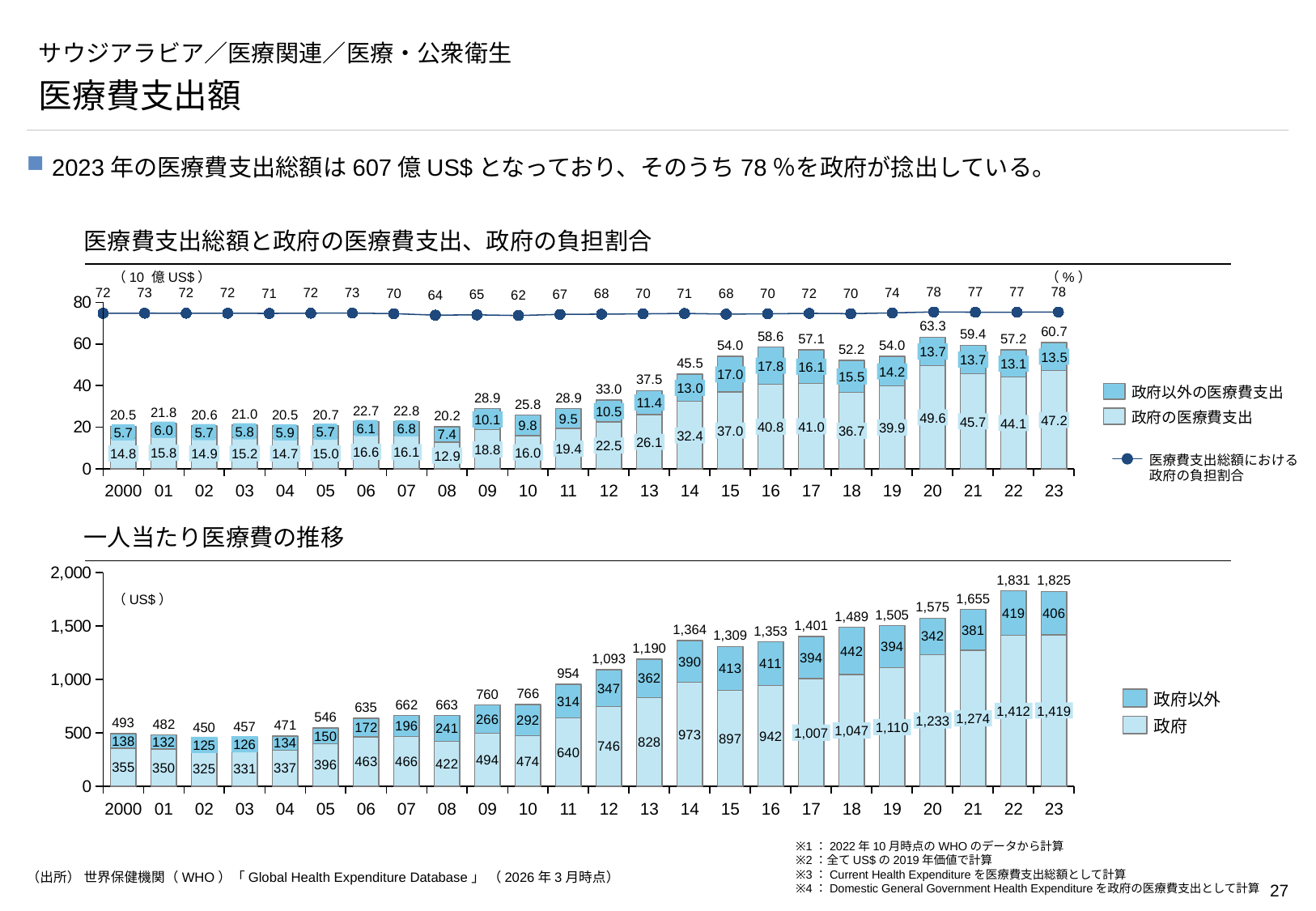
How many series does the legend of the top chart list? 3 In the top chart (医療費支出総額と政府の医療費支出、政府の負担割合), what is the value of 政府の医療費支出 for 2023? 47.2 In the top chart, what is the difference between the total health expenditure in 2023 and in 2022? 3.5 In the bottom chart, what is the 政府以外 value for 2018? 442 In the top chart, in which year is the government share (政府の負担割合) lowest? 2010 (62) In the top chart, which year has the highest total health expenditure? 2020 (63.3) What kind of chart is the bottom chart (一人当たり医療費の推移)? Stacked bar chart In the top chart, what is the government share (政府の負担割合) shown for 2010? 62 In the bottom chart (一人当たり医療費の推移), what is the total per-capita health expenditure for 2022? 1,831 In the bottom chart, which year has the larger 政府 value, 2014 or 2015? 2014 In the bottom chart, which year has the lowest total per-capita health expenditure? 2002 (450) How many years are shown on the x axis of the bottom chart? 24